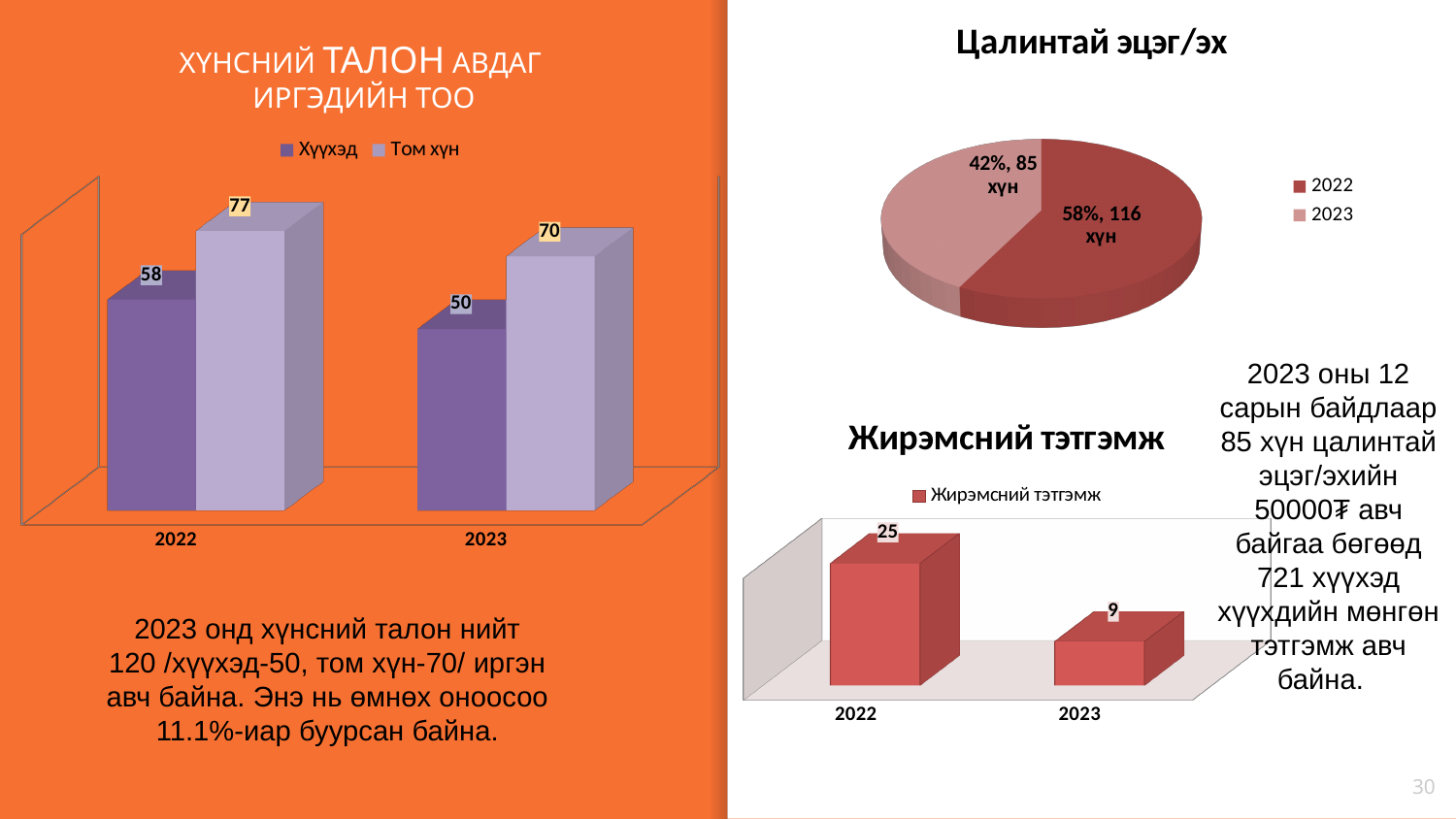
In the pie chart titled 'Цалинтай эцэг/эх', how many people (хүн) are shown for 2023? 85 хүн In the chart titled 'ХҮНСНИЙ ТАЛОН АВДАГ ИРГЭДИЙН ТОО', which is larger in 2023: Хүүхэд or Том хүн? Том хүн In the chart titled 'ХҮНСНИЙ ТАЛОН АВДАГ ИРГЭДИЙН ТОО', what is the difference between the Том хүн values for 2022 and 2023? 7 In the chart titled 'Жирэмсний тэтгэмж', what is the value for 2022? 25 What kind of chart is the chart titled 'Цалинтай эцэг/эх'? pie chart In the chart titled 'ХҮНСНИЙ ТАЛОН АВДАГ ИРГЭДИЙН ТОО', how many series does the legend list? 2 In the chart titled 'ХҮНСНИЙ ТАЛОН АВДАГ ИРГЭДИЙН ТОО', does the Хүүхэд value rise or fall from 2022 to 2023? fall In the chart titled 'Жирэмсний тэтгэмж', what is the difference between the 2022 and 2023 values? 16 In the chart titled 'Жирэмсний тэтгэмж', which year has the lowest value? 2023 In the chart titled 'ХҮНСНИЙ ТАЛОН АВДАГ ИРГЭДИЙН ТОО', what is the value for Хүүхэд in 2022? 58 In the chart titled 'ХҮНСНИЙ ТАЛОН АВДАГ ИРГЭДИЙН ТОО', what is the value for Том хүн in 2023? 70 In the pie chart titled 'Цалинтай эцэг/эх', what share does 2022 have? 58%